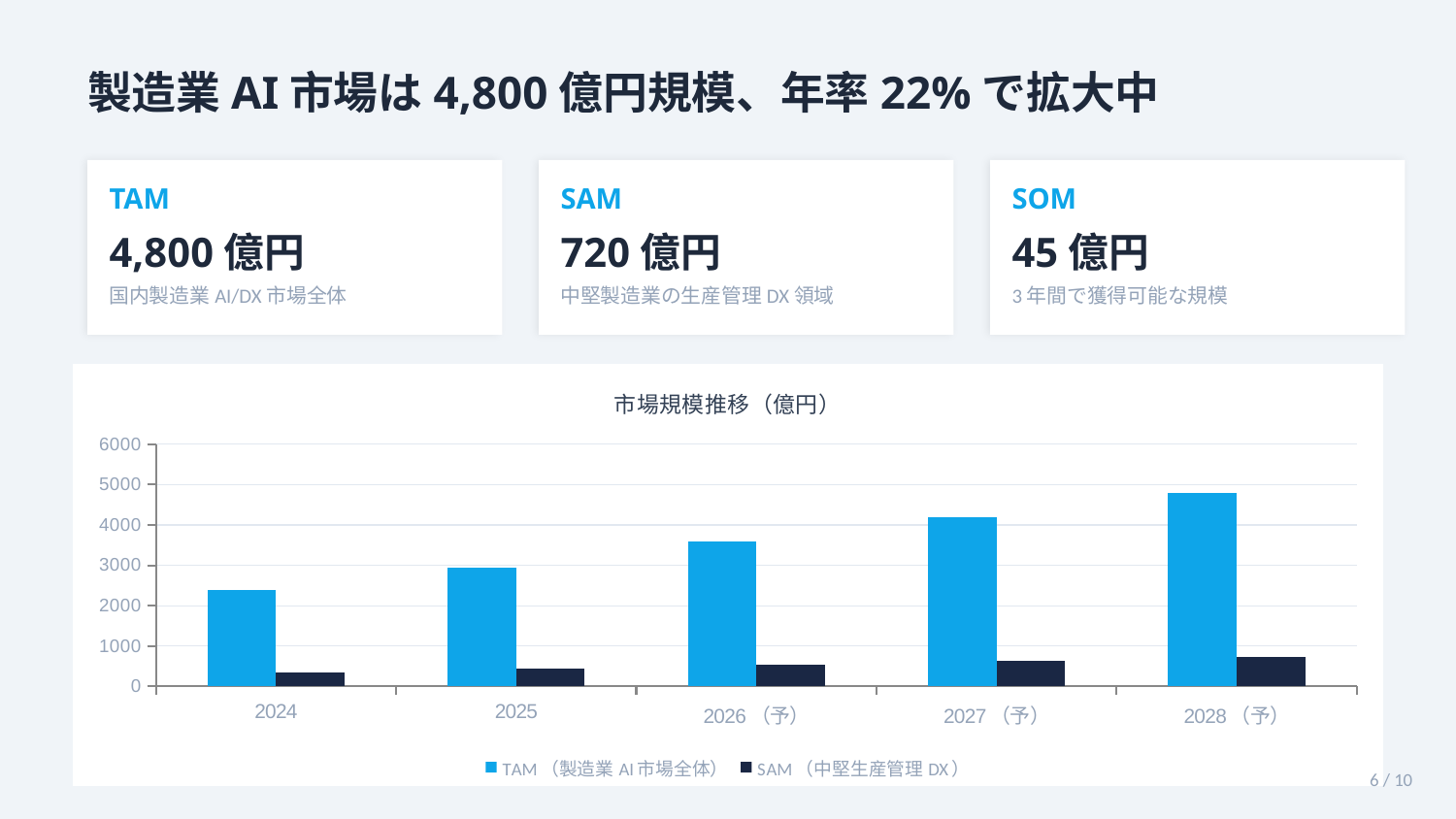
How many series does the chart legend list? 2 Which year has the highest TAM value in the chart? 2028（予） Which is larger in 2026（予）, the TAM bar or the SAM bar? TAM Is the TAM value for 2028（予） greater or less than 5000? less Is the SAM value for 2028（予） greater or less than 1000? less Do the TAM values rise or fall from 2024 to 2028（予）? rise Which series is shown in dark navy in the chart? SAM（中堅生産管理 DX） What is the title of the chart? 市場規模推移（億円） How many years are shown on the x axis of the chart? 5 Which year has the lowest TAM value in the chart? 2024 What kind of chart is shown on the slide? bar chart Is the TAM value for 2024 greater or less than 2000? greater